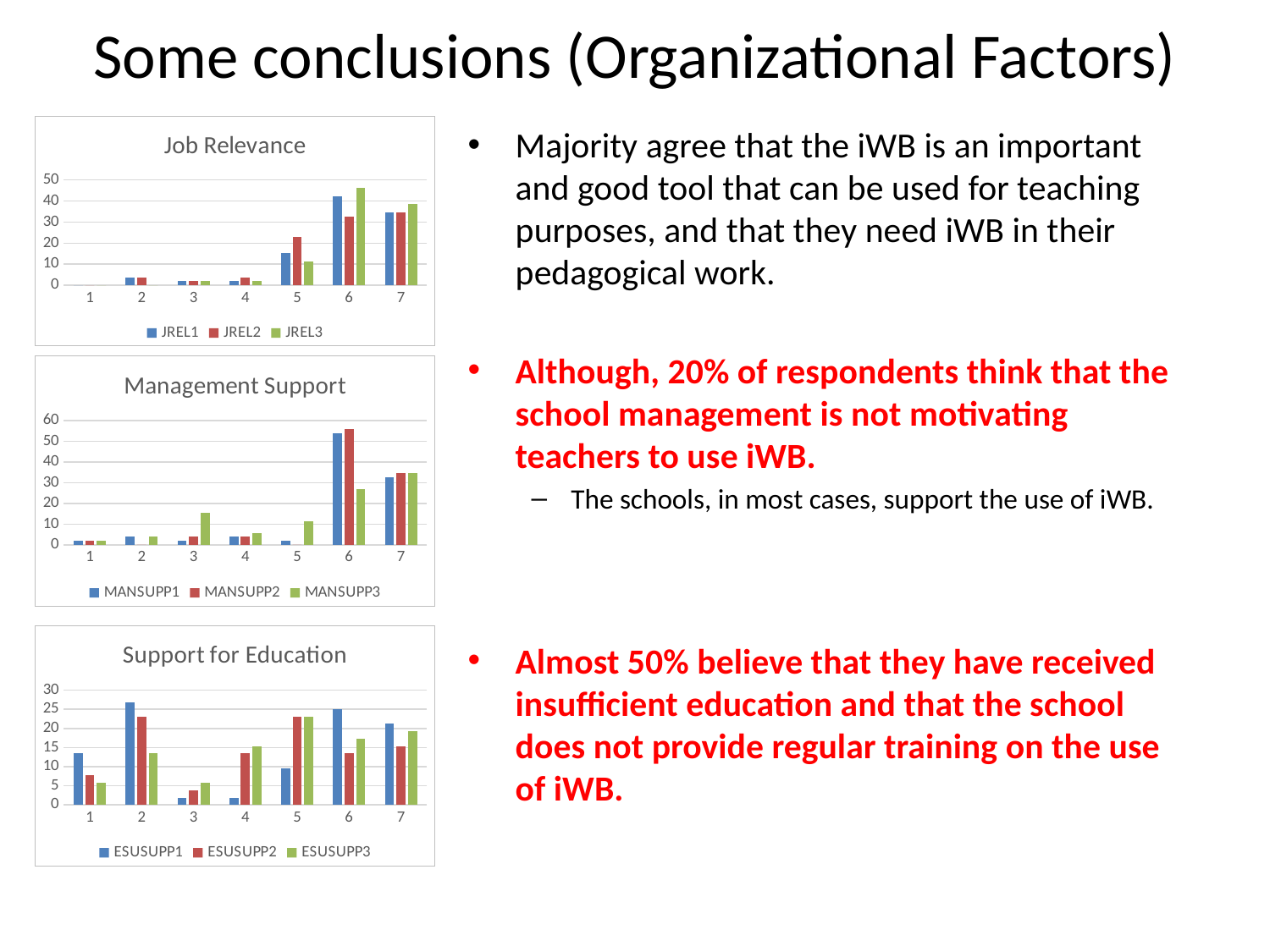
In the Job Relevance chart, is the value for JREL3 at category 6 greater or less than 40? greater In the Management Support chart, is the value for MANSUPP3 at category 6 greater or less than 40? less In the Management Support chart, at category 6, which is larger: MANSUPP1 or MANSUPP3? MANSUPP1 In the Support for Education chart, is the value for ESUSUPP1 at category 2 greater or less than 20? greater In the Job Relevance chart, which category has the highest JREL1 value? 6 What are the legend entries of the Support for Education chart? ESUSUPP1, ESUSUPP2, ESUSUPP3 What kind of chart is the Job Relevance chart? bar chart In the Job Relevance chart, how many series does the legend list? 3 In the Management Support chart, at category 3, which is larger: MANSUPP1 or MANSUPP3? MANSUPP3 In the Management Support chart, how many categories are shown on the x axis? 7